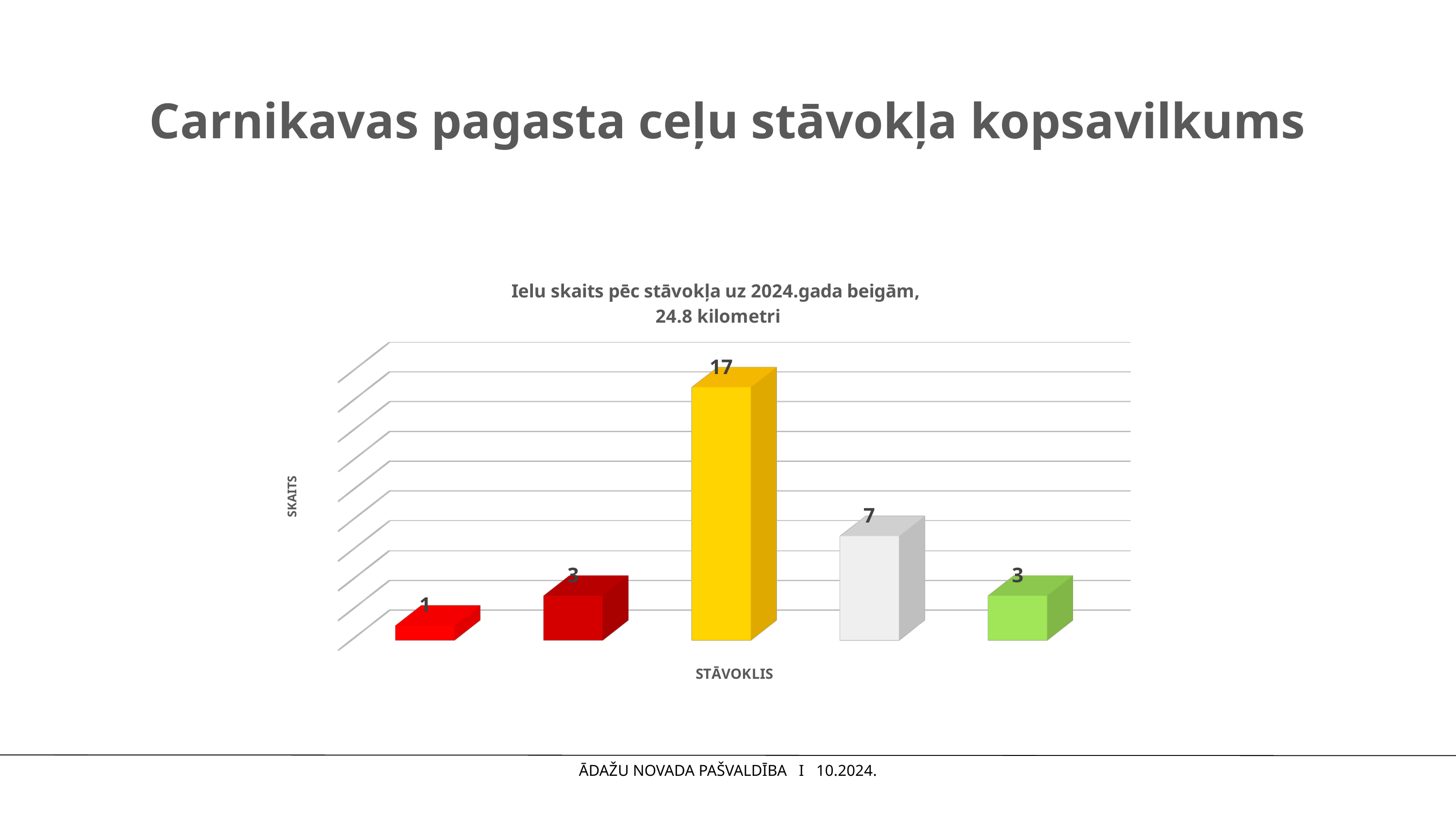
What is the value of the last (rightmost, green) bar? 3 Which is larger: the value of the grey bar or the value of the green bar? the grey bar (7) What is the value of the fourth bar (the grey one)? 7 Which bar has the highest value? the yellow bar (third from the left), 17 What type of chart is shown on the slide? bar chart What is the value of the tallest bar (the yellow one, third from the left)? 17 Which bar has the lowest value? the leftmost bright red bar, 1 What is the value of the first (leftmost, bright red) bar? 1 What is the label of the vertical axis? SKAITS What is the title of the chart? Ielu skaits pēc stāvokļa uz 2024.gada beigām, 24.8 kilometri How many bars does the chart contain? 5 What is the difference between the yellow bar's value and the grey bar's value? 10